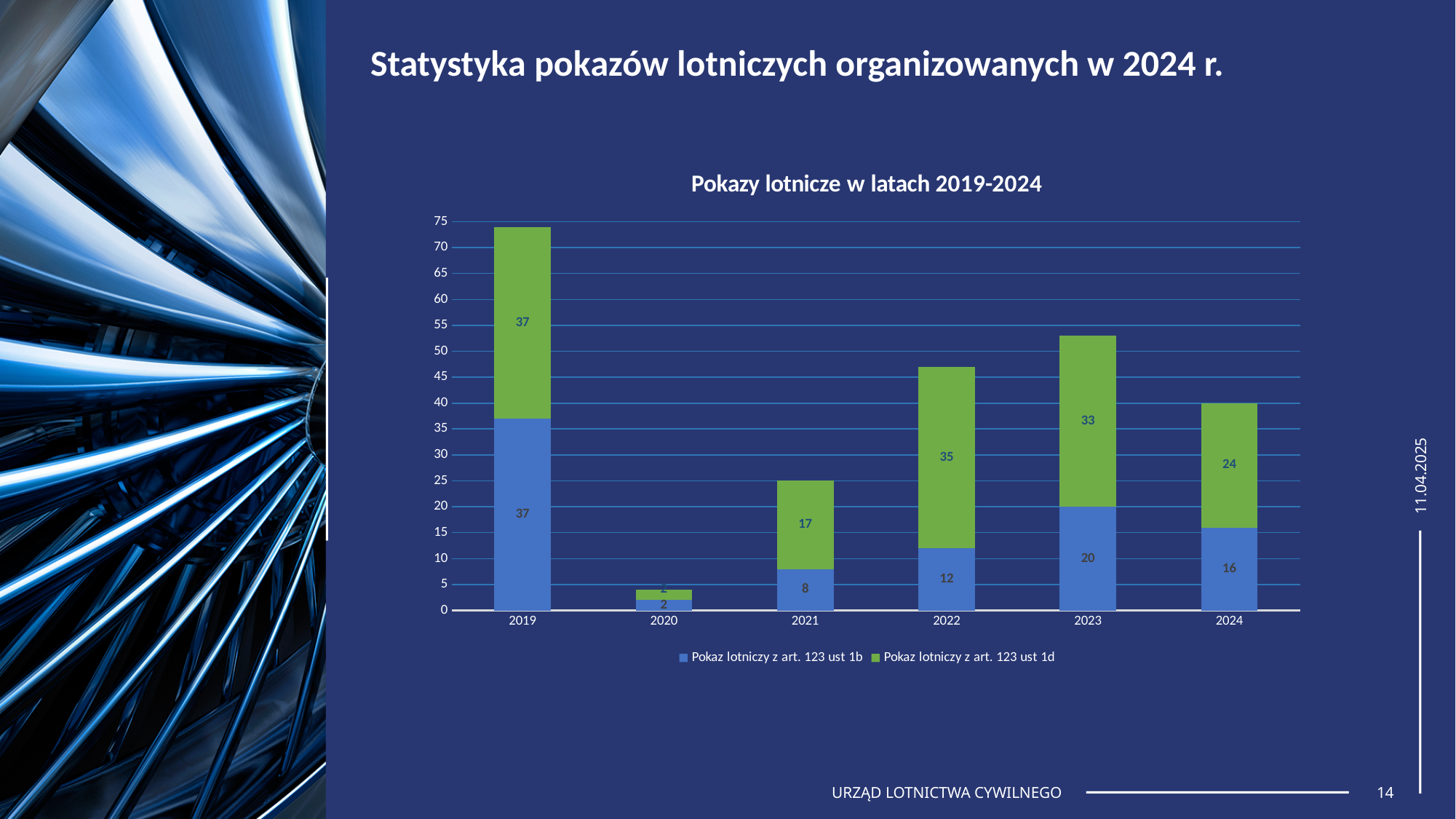
What type of chart is shown on the slide? stacked bar chart What is the total of the stacked bar for 2024? 40 Which year has the lowest value for 'Pokaz lotniczy z art. 123 ust 1b'? 2020 How many years are shown on the x axis? 6 What is the value for 'Pokaz lotniczy z art. 123 ust 1b' in 2023? 20 What is the value for 'Pokaz lotniczy z art. 123 ust 1d' in 2022? 35 What is the title of the chart? Pokazy lotnicze w latach 2019-2024 What is the value for 'Pokaz lotniczy z art. 123 ust 1b' in 2021? 8 How many series does the legend list? 2 What is the difference between the 'Pokaz lotniczy z art. 123 ust 1d' values for 2023 and 2024? 9 Which year has the highest value for 'Pokaz lotniczy z art. 123 ust 1d'? 2019 Is the 'Pokaz lotniczy z art. 123 ust 1b' value for 2022 larger or smaller than the value for 2024? smaller